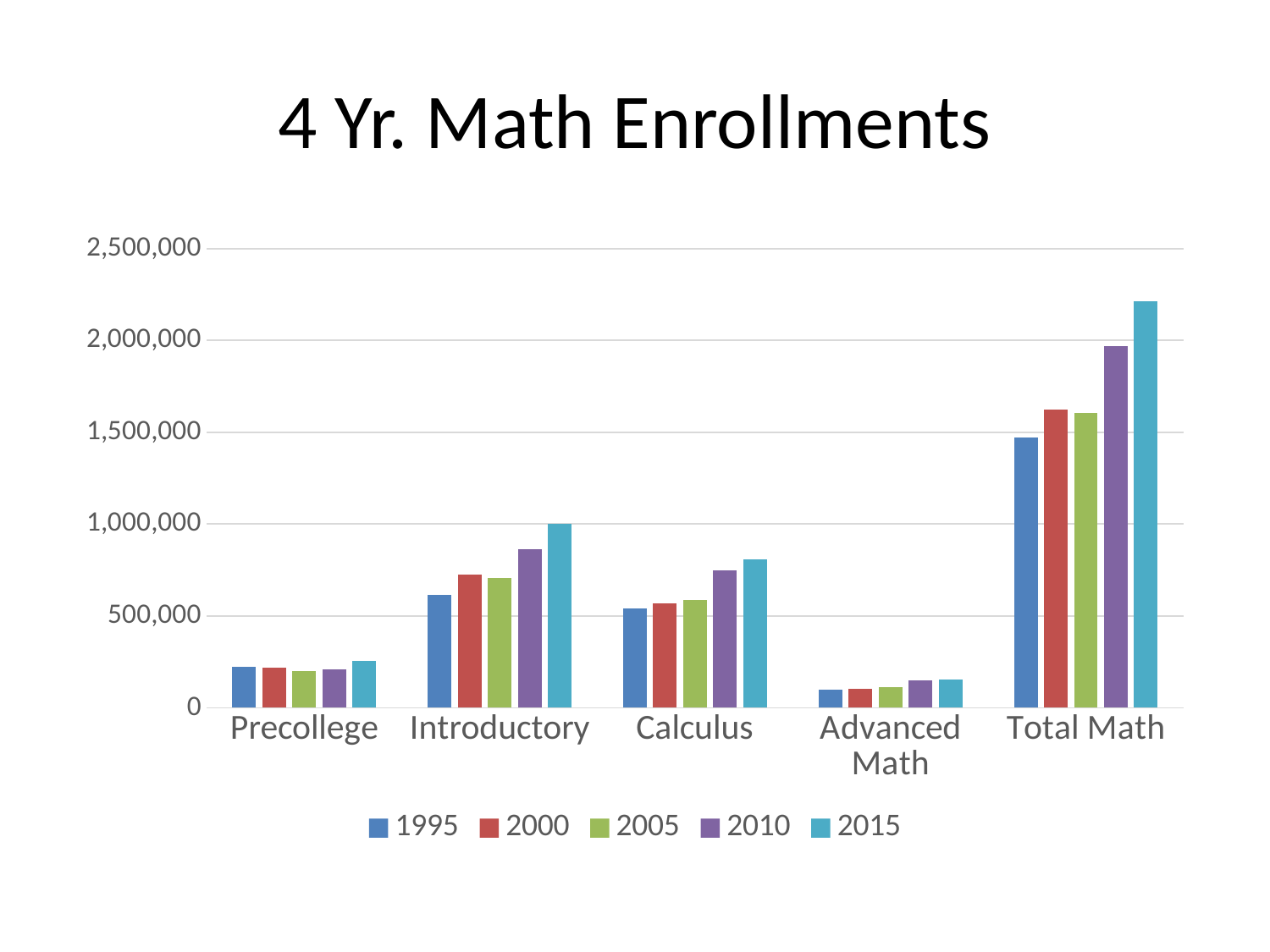
Is the value for Calculus in 2015 greater or less than 1,000,000? less What kind of chart is shown on the slide? bar chart How many series does the legend list? 5 What is the title of the chart? 4 Yr. Math Enrollments Is the value for Total Math in 1995 greater or less than 1,500,000? less Is the value for Introductory in 1995 greater or less than 500,000? greater How many categories are shown on the x axis? 5 Which category has the highest enrollment for 2015? Total Math Which category has the lowest enrollment for 2015? Advanced Math Which is larger for Total Math: the 2010 value or the 2000 value? 2010 Do the Total Math values rise or fall from 2005 to 2015? rise